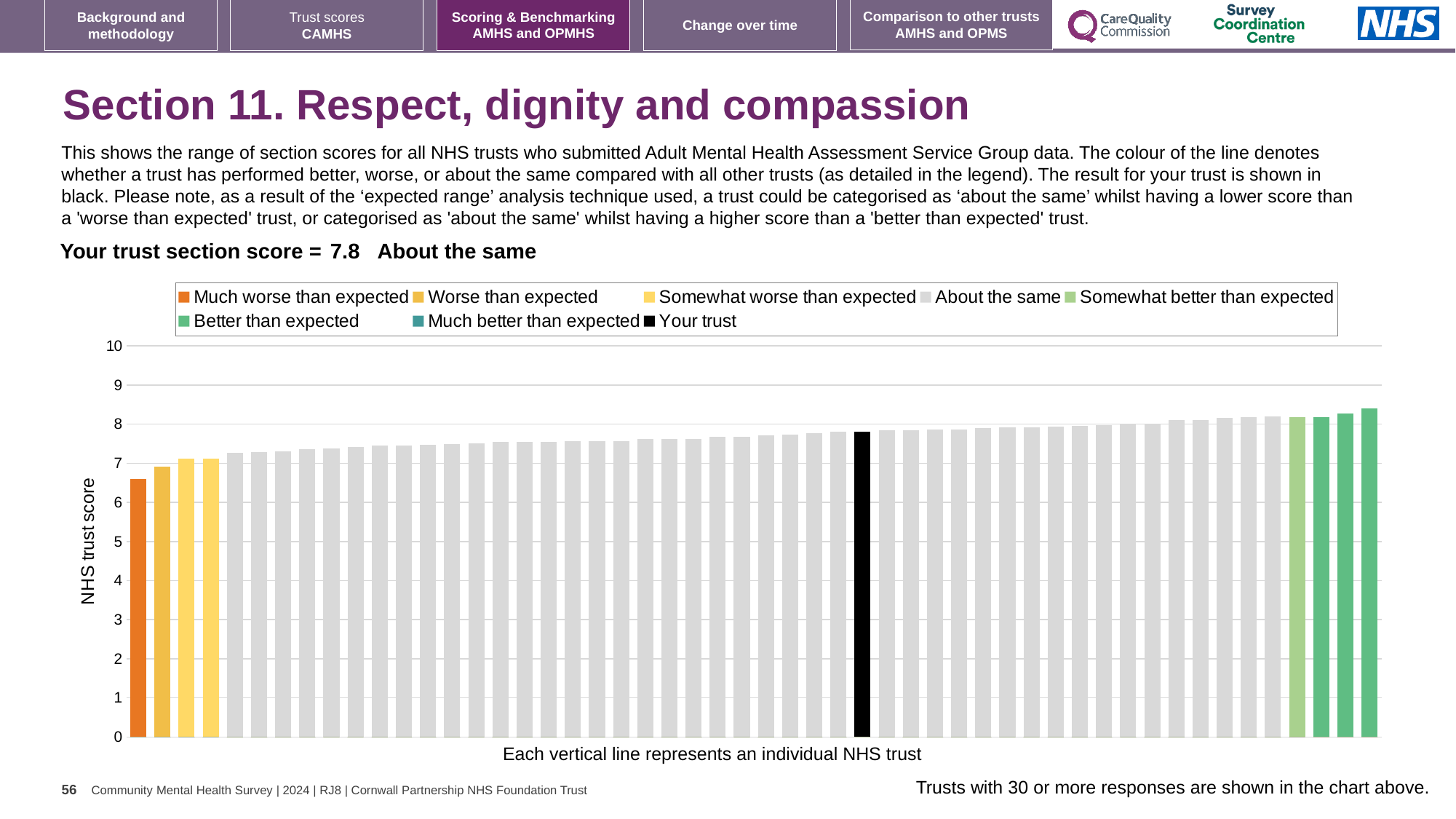
Which legend category does the lowest bar in the chart belong to? Much worse than expected Which legend category does the highest bar in the chart belong to? Better than expected Is the value of the orange 'Much worse than expected' bar greater or less than 7? less Do the bar values rise or fall from left to right along the x axis? rise How many bars in the chart are coloured orange ('Much worse than expected')? 1 What is the title of the vertical axis of the chart? NHS trust score Is the value of the tallest bar in the chart greater or less than 8? greater What kind of chart is shown on the slide? bar chart Is the value of the black 'Your trust' bar greater or less than 7? greater What is the section score for your trust shown on the slide? 7.8 How many entries does the chart legend list? 8